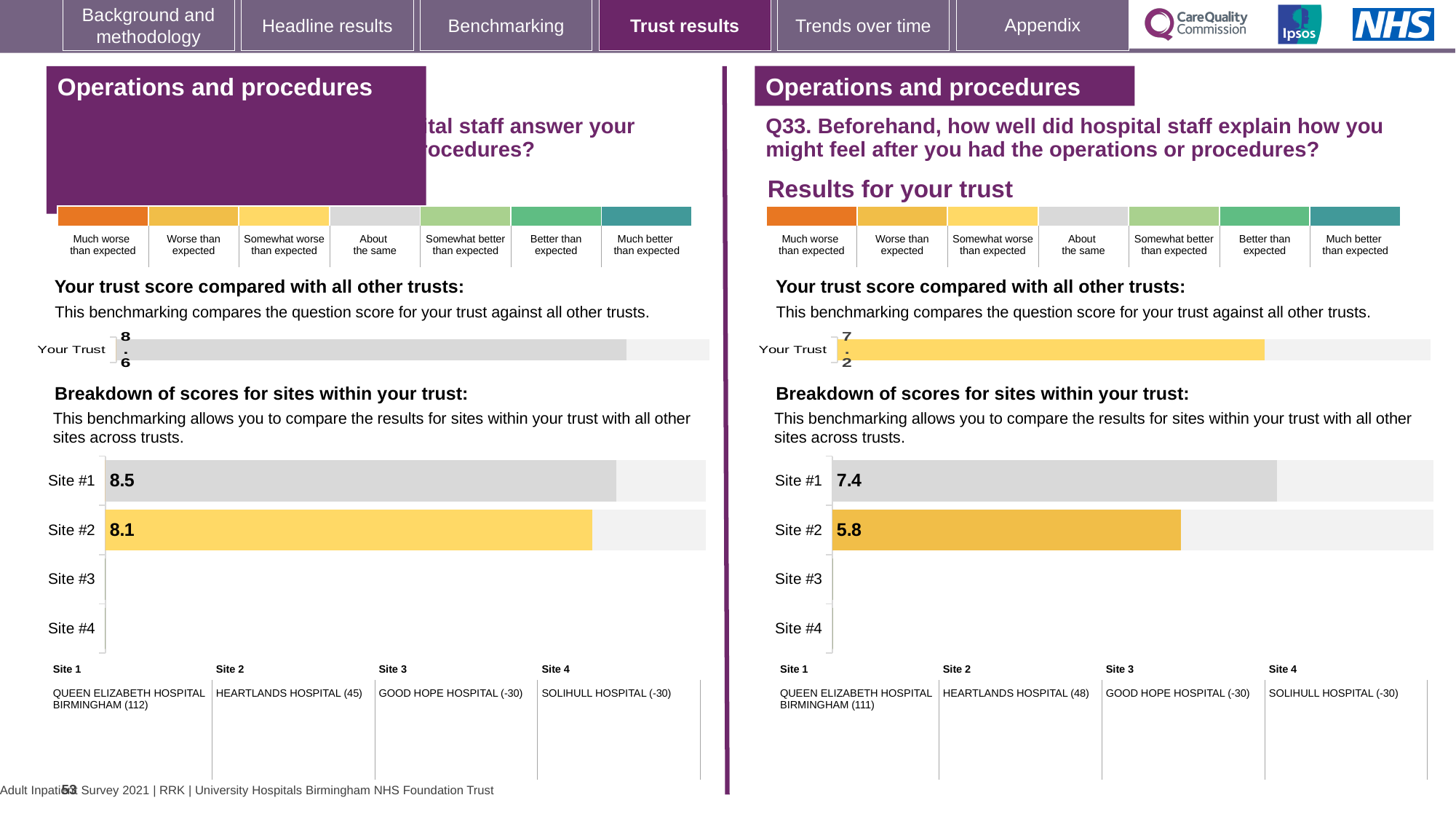
On the right half of the slide (Q33), how many site categories are listed on the axis of the site breakdown chart? 4 On the right half of the slide (Q33), what is the 'Your Trust' score shown in the 'Your trust score compared with all other trusts' chart? 7.2 What kind of chart is used for the 'Breakdown of scores for sites within your trust' on the right half of the slide (Q33)? Bar chart On the left half of the slide, in the site breakdown chart, what is the difference between the Site #1 and Site #2 scores? 0.4 On the right half of the slide (Q33), in the 'Breakdown of scores for sites within your trust' chart, what is the score for Site #1? 7.4 On the right half of the slide (Q33), in the site breakdown chart, what is the difference between the Site #1 and Site #2 scores? 1.6 On the left half of the slide, in the 'Breakdown of scores for sites within your trust' chart, what is the score for Site #2? 8.1 On the right half of the slide (Q33), in the site breakdown chart, which site has the lowest score among those with a bar shown? Site #2 On the left half of the slide, what is the 'Your Trust' score shown in the 'Your trust score compared with all other trusts' chart? 8.6 On the right half of the slide (Q33), in the site breakdown chart, which site has the higher score, Site #1 or Site #2? Site #1 On the left half of the slide, in the 'Breakdown of scores for sites within your trust' chart, what is the score for Site #1? 8.5 On the right half of the slide (Q33), in the 'Breakdown of scores for sites within your trust' chart, what is the score for Site #2? 5.8